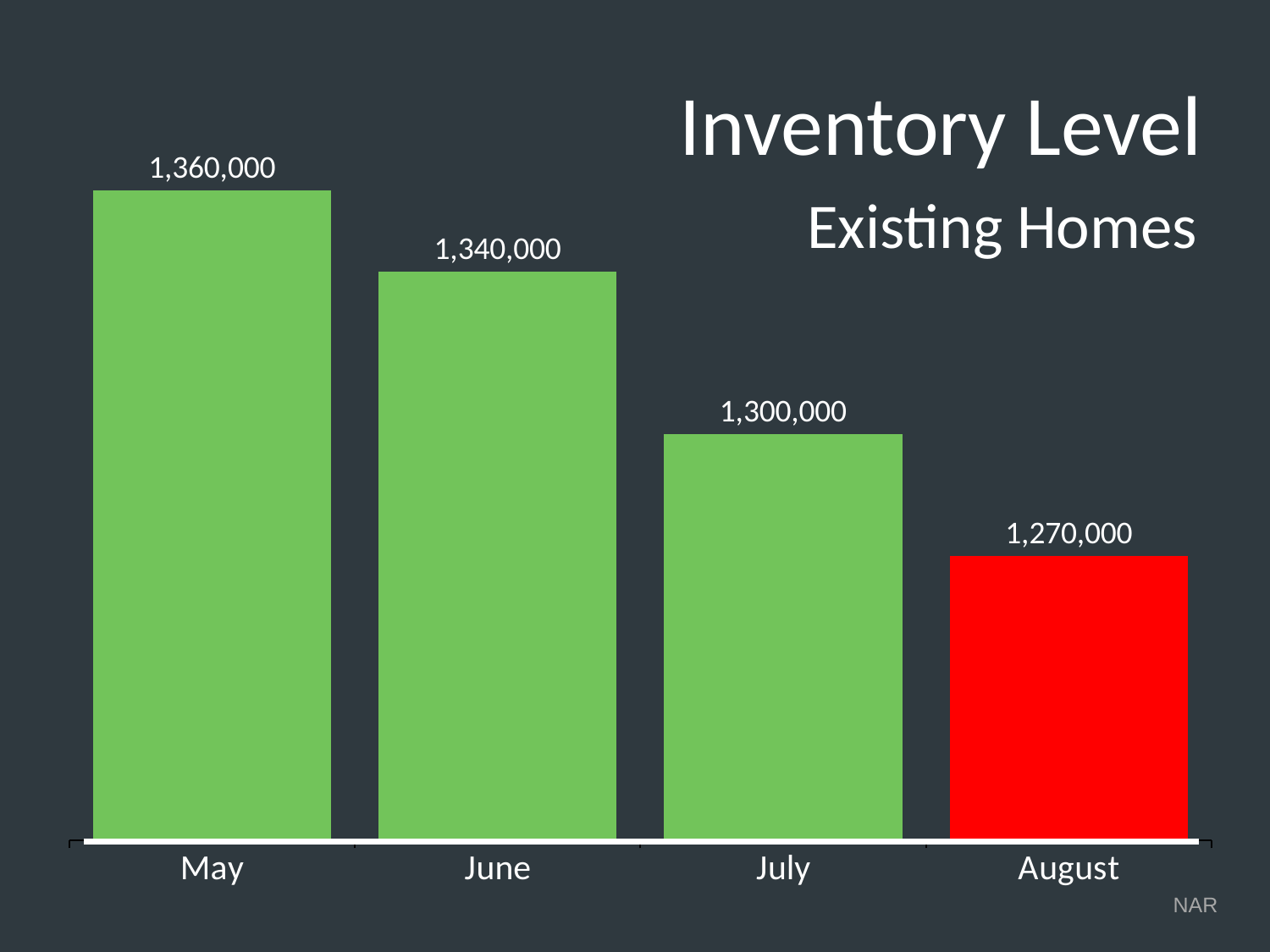
What is the difference between the inventory levels for June and July? 40,000 How many months are shown on the chart? 4 What is the inventory level for May? 1,360,000 Do the inventory levels rise or fall from May to August? Fall Which month has the lowest inventory level? August What kind of chart is shown on the slide? Bar chart What is the inventory level for July? 1,300,000 Which month has the highest inventory level? May What is the inventory level for August? 1,270,000 What is the difference between the inventory levels for May and August? 90,000 Which month's bar is coloured red? August Which is larger, the inventory level for June or for July? June